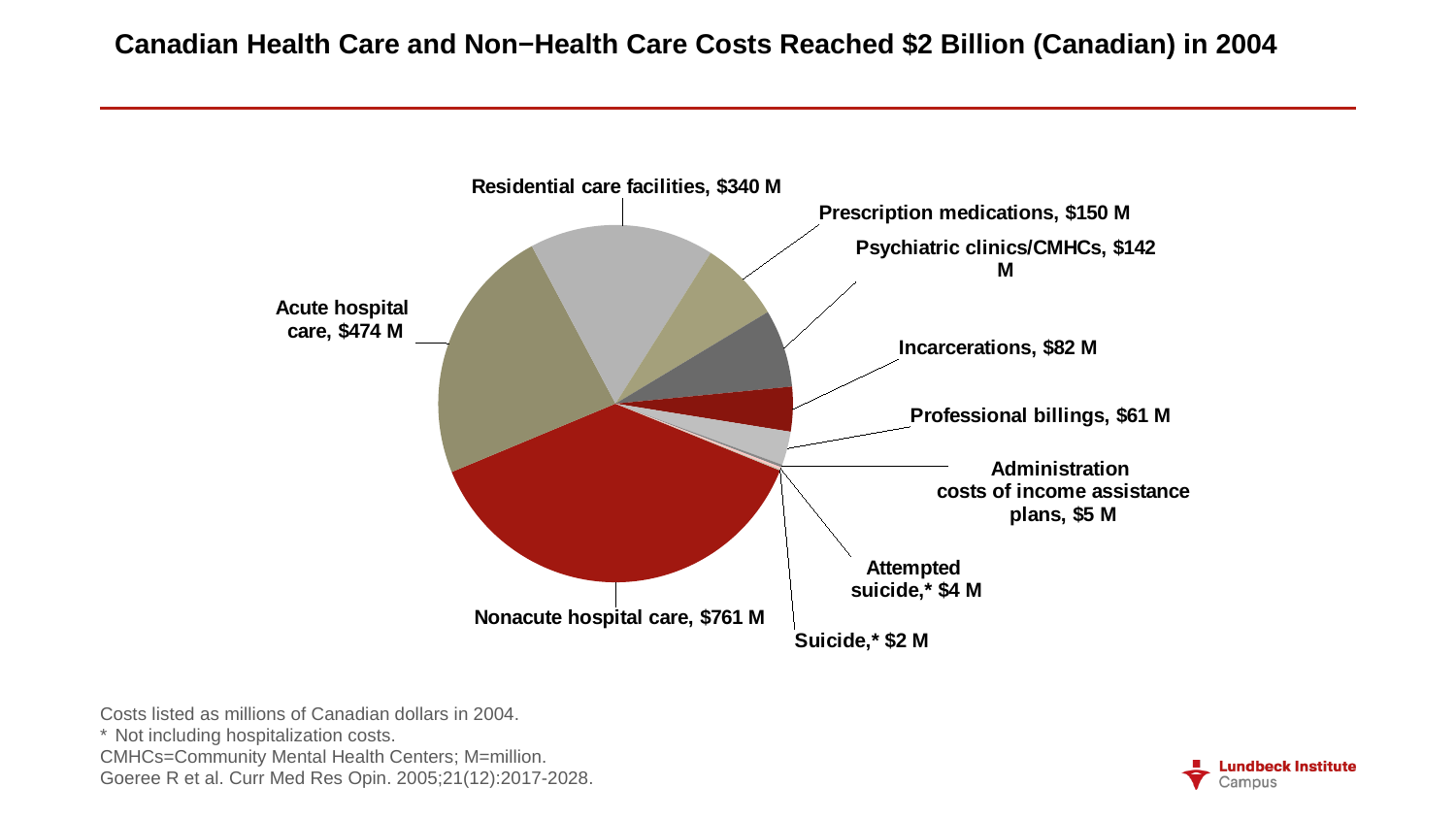
What is the cost for Administration costs of income assistance plans? $5 M What is the cost for Residential care facilities? $340 M What is the cost for Psychiatric clinics/CMHCs? $142 M What kind of chart is shown on the slide? Pie chart What is the difference between the cost of Nonacute hospital care and Acute hospital care? $287 M What is the cost for Acute hospital care? $474 M What is the title of the slide? Canadian Health Care and Non−Health Care Costs Reached $2 Billion (Canadian) in 2004 What is the cost for Nonacute hospital care? $761 M Which is larger, the cost for Prescription medications or for Incarcerations? Prescription medications Which category has the smallest cost? Suicide Which category has the largest cost? Nonacute hospital care How many categories are shown in the pie chart? 10